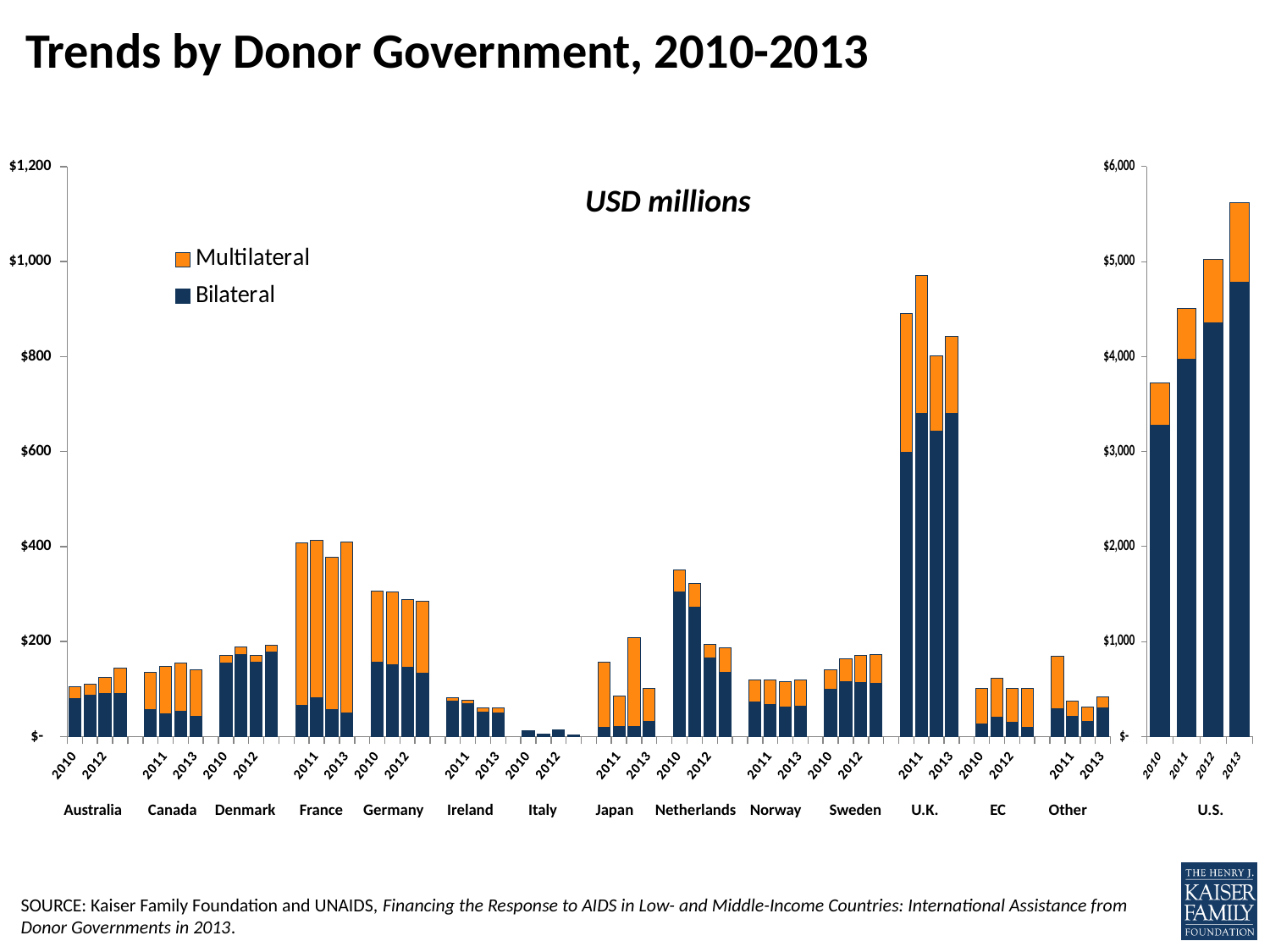
In the right chart (U.S.), do the totals rise or fall from 2010 to 2013? Rise In the right chart (U.S.), is the total value for 2013 greater or less than $5,000? greater In the left chart, which donor government has the tallest bars? U.K. In the left chart, is the total value for Germany in 2010 greater or less than $200? greater How many series does the legend list? 2 In the left chart, is the total value for U.K. in 2011 greater or less than $800? greater What are the two series named in the legend? Multilateral and Bilateral What kind of chart is used on this slide? Stacked bar chart In the left chart, do the Netherlands totals rise or fall from 2010 to 2013? Fall In the left chart, which is larger for Japan: the 2011 total or the 2012 total? 2012 In the left chart, which donor government has the lowest bars? Italy